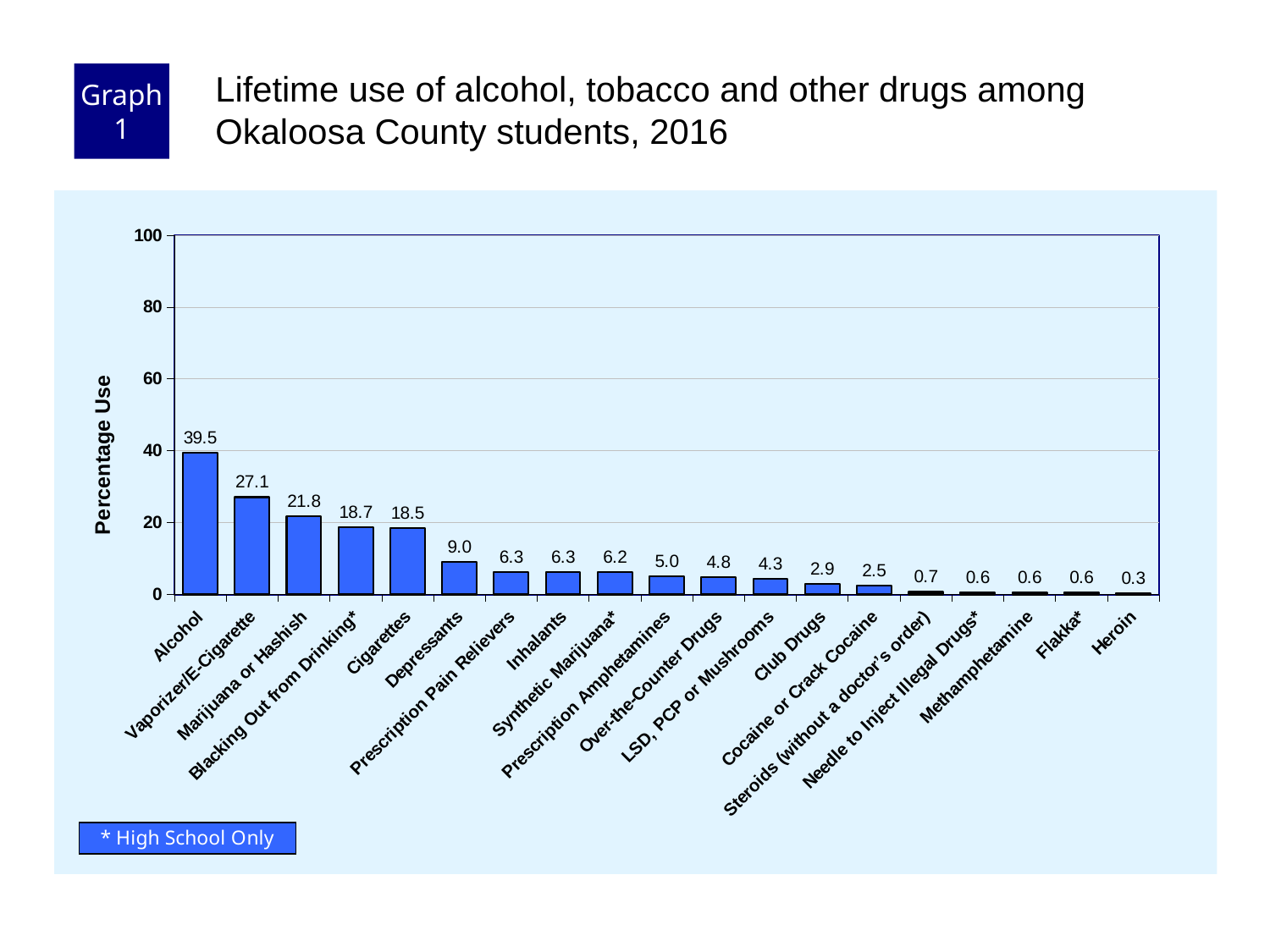
Which category has the lowest percentage use? Heroin What is the percentage use for Depressants? 9.0 Is the value for Alcohol greater or less than 40? less How many categories are shown on the x axis? 19 What is the label of the y axis? Percentage Use What kind of chart is shown on the slide? bar chart What is the percentage use for Alcohol? 39.5 Which category has the highest percentage use? Alcohol What is the difference in percentage use between Alcohol and Vaporizer/E-Cigarette? 12.4 Which has a higher percentage use, Marijuana or Hashish or Cigarettes? Marijuana or Hashish What is the percentage use for Cocaine or Crack Cocaine? 2.5 What is the percentage use for Vaporizer/E-Cigarette? 27.1